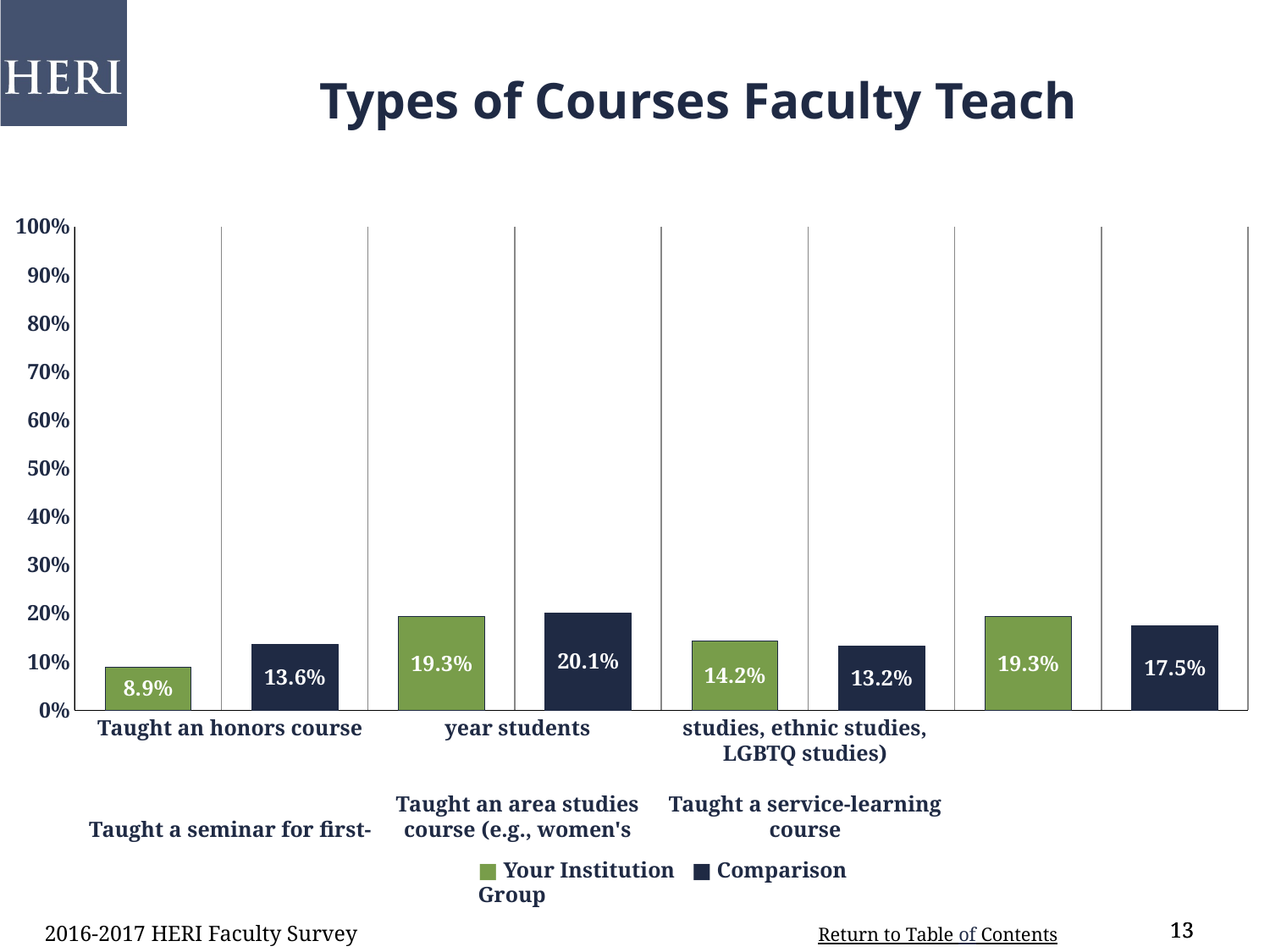
Which category has the lowest Your Institution value? Taught an honors course For "Taught a service-learning course", which is larger: Your Institution or Comparison Group? Your Institution What kind of chart is shown on the slide? Bar chart Which category has the highest Comparison Group value? Taught a seminar for first-year students Is the Comparison Group value for "Taught a seminar for first-year students" greater or less than 30%? less What is the Comparison Group value for "Taught an area studies course"? 13.2% What is the Your Institution value for "Taught a service-learning course"? 19.3% What is the value for Your Institution for "Taught an honors course"? 8.9% How many series does the legend list? 2 What is the Comparison Group value for "Taught a seminar for first-year students"? 20.1% What is the difference between the Comparison Group and Your Institution values for "Taught an honors course"? 4.7% How many categories are shown on the x axis? 4